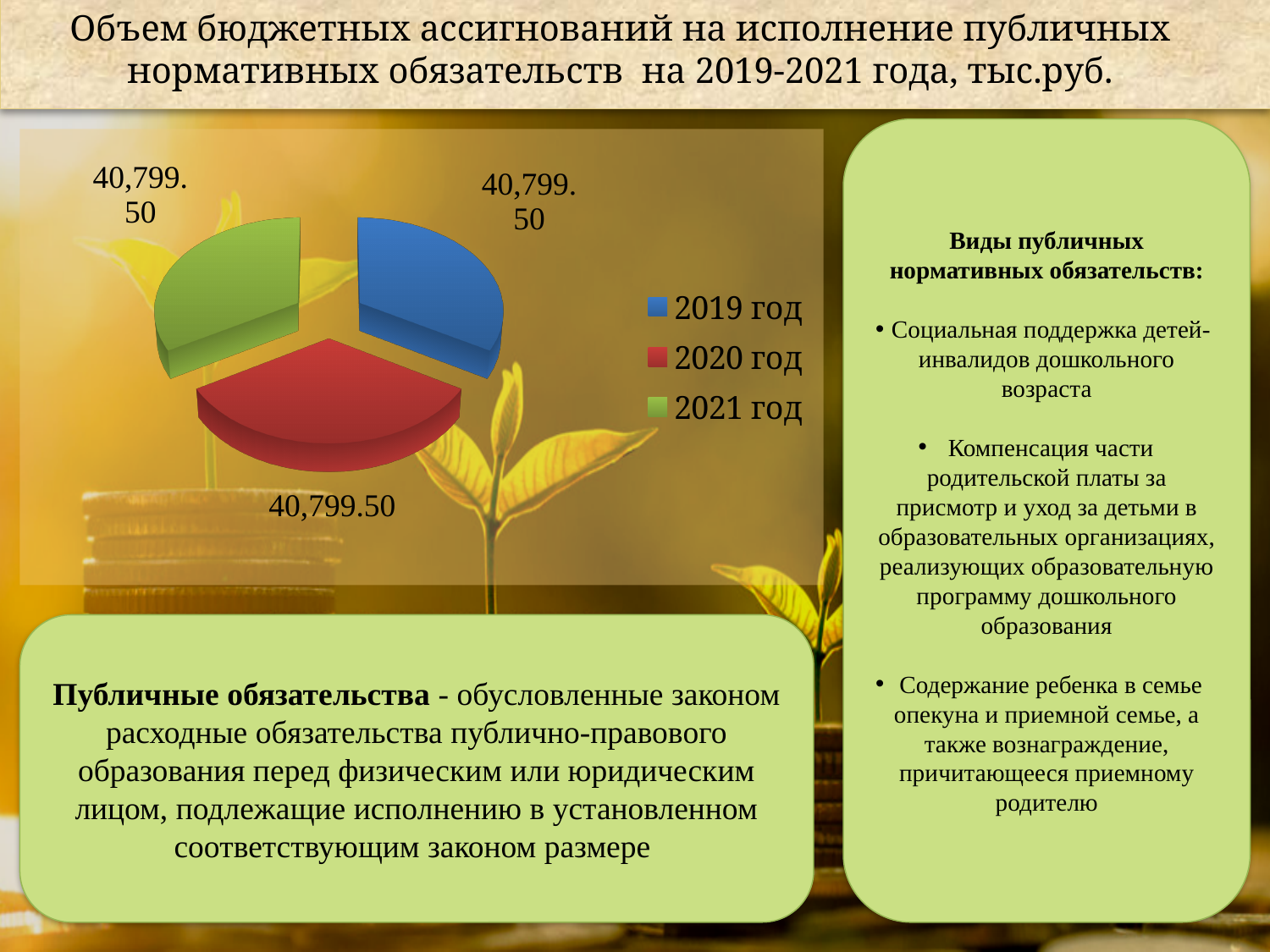
Which is larger, the value for 2020 год or the value for 2021 год? They are equal How many slices does the pie chart have? 3 What is the total of the three values shown in the pie chart? 122,398.50 What colour is the slice for 2020 год? Red What is the value for 2019 год in the pie chart? 40,799.50 What is the value for 2021 год in the pie chart? 40,799.50 What is the difference between the values for 2019 год and 2021 год? 0 What share of the pie does the 2020 год slice represent? One third What is the value for 2020 год in the pie chart? 40,799.50 What unit is stated in the chart title for the budget allocations? тыс.руб. How many entries does the chart legend list? 3 What kind of chart is shown on the slide? Pie chart